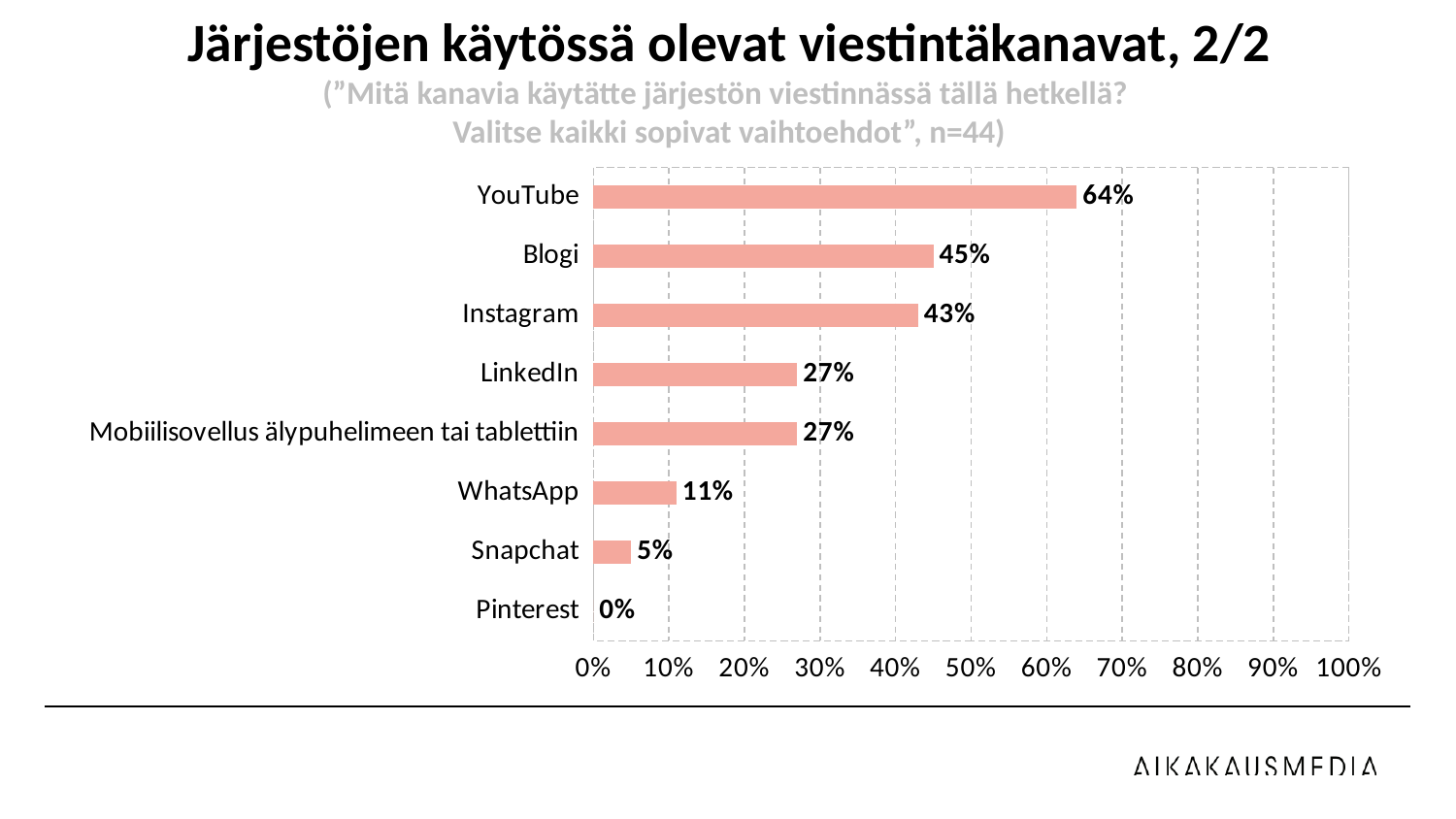
What is the value for Pinterest? 0% What is the difference between the values for YouTube and Blogi? 19% Is the value for Snapchat greater or less than 10%? less What is the value for WhatsApp? 11% How many categories are shown in the chart? 8 Which category has the lowest value? Pinterest What kind of chart is shown on the slide? bar chart Which category has the highest value? YouTube What is the title of the chart? Järjestöjen käytössä olevat viestintäkanavat, 2/2 Which is larger, the value for Blogi or the value for LinkedIn? Blogi What is the value for YouTube? 64% What is the value for Instagram? 43%